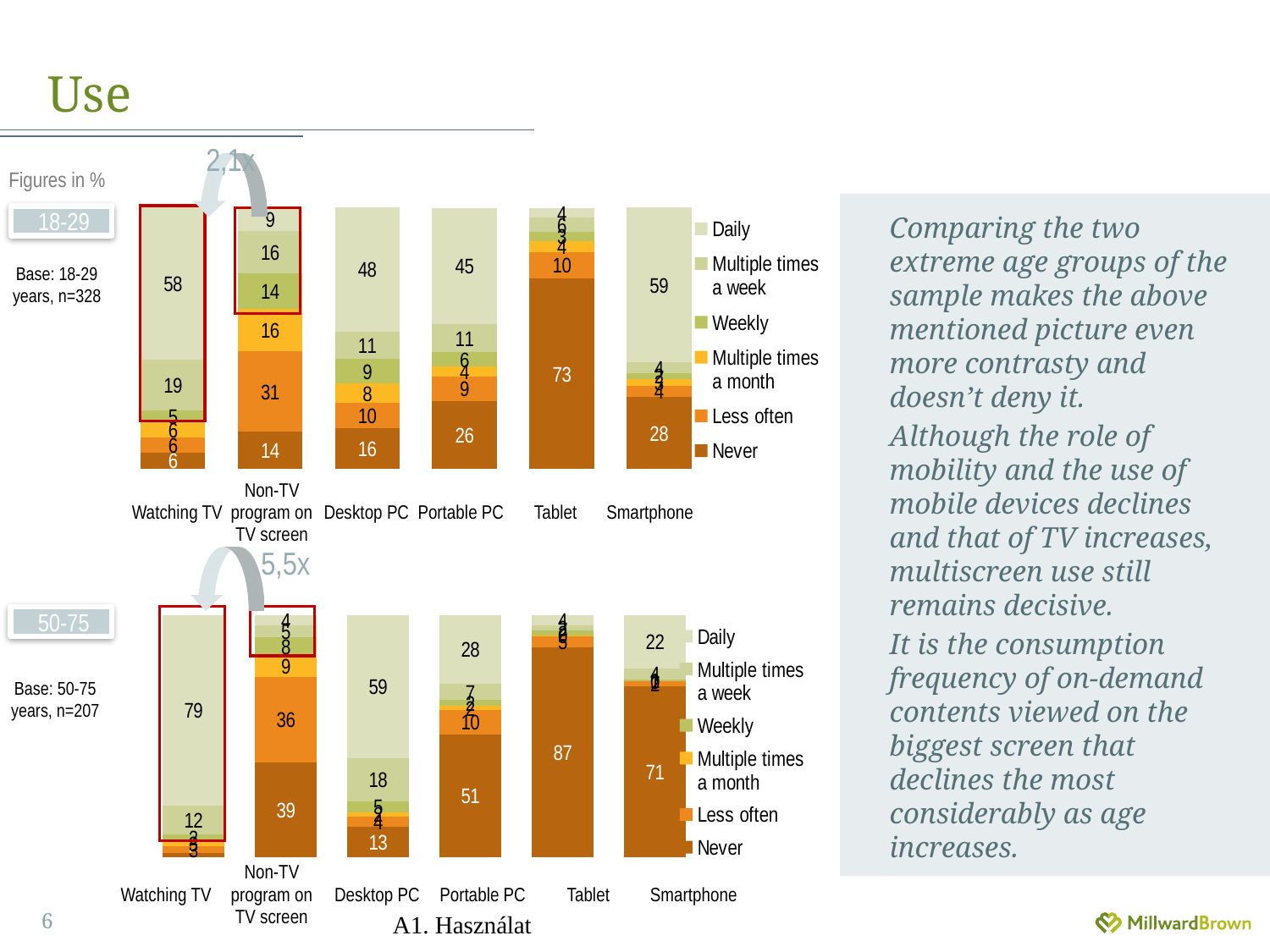
In the 50-75 chart (bottom), what is the Never value for Smartphone? 71 In the 18-29 chart (top), what is the Less often value for Non-TV program on TV screen? 31 In the 18-29 chart (top), what is the difference between the Daily values for Smartphone and Desktop PC? 11 In the 18-29 chart (top), what is the Daily value for Watching TV? 58 In the 50-75 chart (bottom), what is the Never value for Portable PC? 51 In the 50-75 chart (bottom), which is larger: the Never value for Tablet or the Never value for Non-TV program on TV screen? Tablet In the 50-75 chart (bottom), which category has the highest Daily value? Watching TV In the 18-29 chart (top), which category has the highest Never value? Tablet In the 18-29 chart (top), what is the Never value for Tablet? 73 In the 50-75 chart (bottom), what is the Daily value for Watching TV? 79 How many series does the legend of the 18-29 chart (top) list? 6 What kind of chart is the 50-75 chart (bottom)? Stacked bar chart